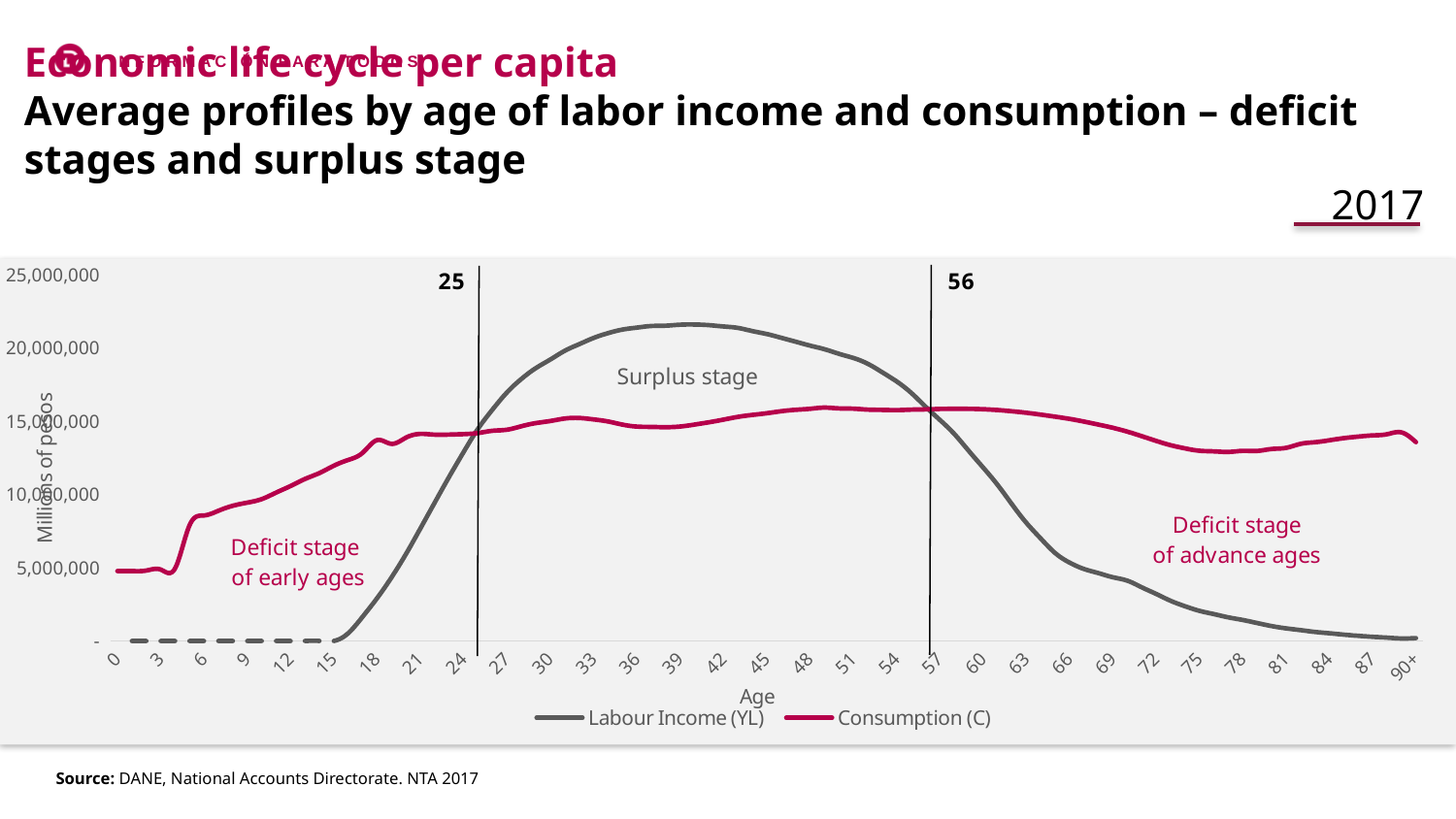
Does Labour Income (YL) rise or fall between age 15 and age 39? rise Which two series are plotted in the chart? Labour Income (YL) and Consumption (C) Is the value of Consumption (C) at age 75 greater or less than 15,000,000? less How many series does the legend list? 2 Is the value of Labour Income (YL) at age 39 greater or less than 20,000,000? greater Is the value of Labour Income (YL) at age 66 greater or less than 10,000,000? less At age 39, which series has the higher value, Labour Income (YL) or Consumption (C)? Labour Income (YL) What ages do the two vertical lines in the chart mark? 25 and 56 At age 75, which series has the higher value, Labour Income (YL) or Consumption (C)? Consumption (C) What kind of chart is shown on the slide? line chart